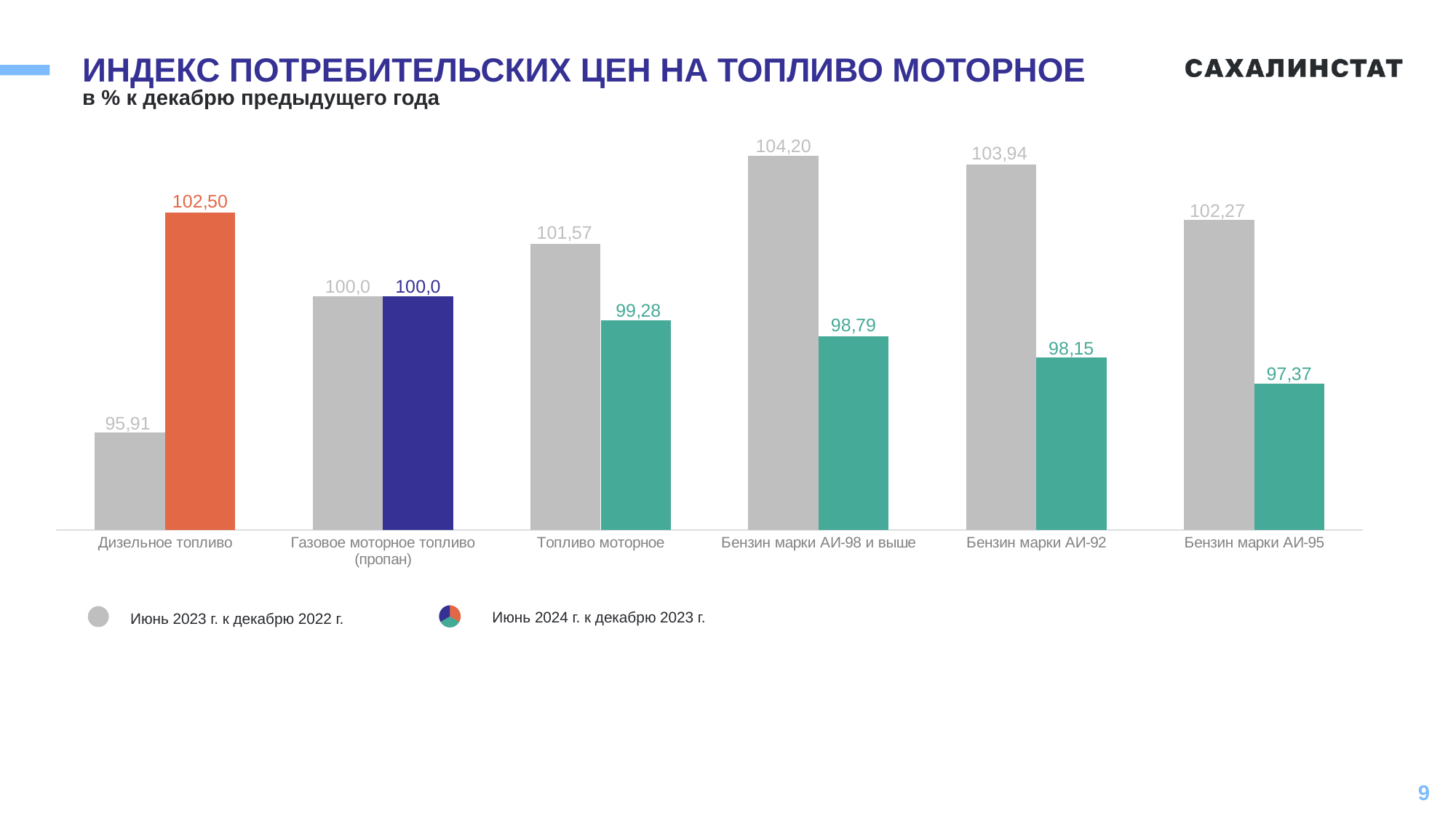
What is the difference between the two series values for Дизельное топливо? 6,59 What is the value for Бензин марки АИ-95 in the series Июнь 2024 г. к декабрю 2023 г.? 97,37 For Топливо моторное, which series has the larger value: Июнь 2023 г. к декабрю 2022 г. or Июнь 2024 г. к декабрю 2023 г.? Июнь 2023 г. к декабрю 2022 г. Which category has the lowest value in the series Июнь 2024 г. к декабрю 2023 г.? Бензин марки АИ-95 Which category has the highest value in the series Июнь 2023 г. к декабрю 2022 г.? Бензин марки АИ-98 и выше What is the difference between the two series values for Бензин марки АИ-92? 5,79 What kind of chart is shown on the slide? Bar chart Which category has the lowest value in the series Июнь 2023 г. к декабрю 2022 г.? Дизельное топливо What is the value for Дизельное топливо in the series Июнь 2024 г. к декабрю 2023 г.? 102,50 How many categories are shown on the x axis? 6 What is the value for Бензин марки АИ-98 и выше in the series Июнь 2023 г. к декабрю 2022 г.? 104,20 How many series does the legend list? 2